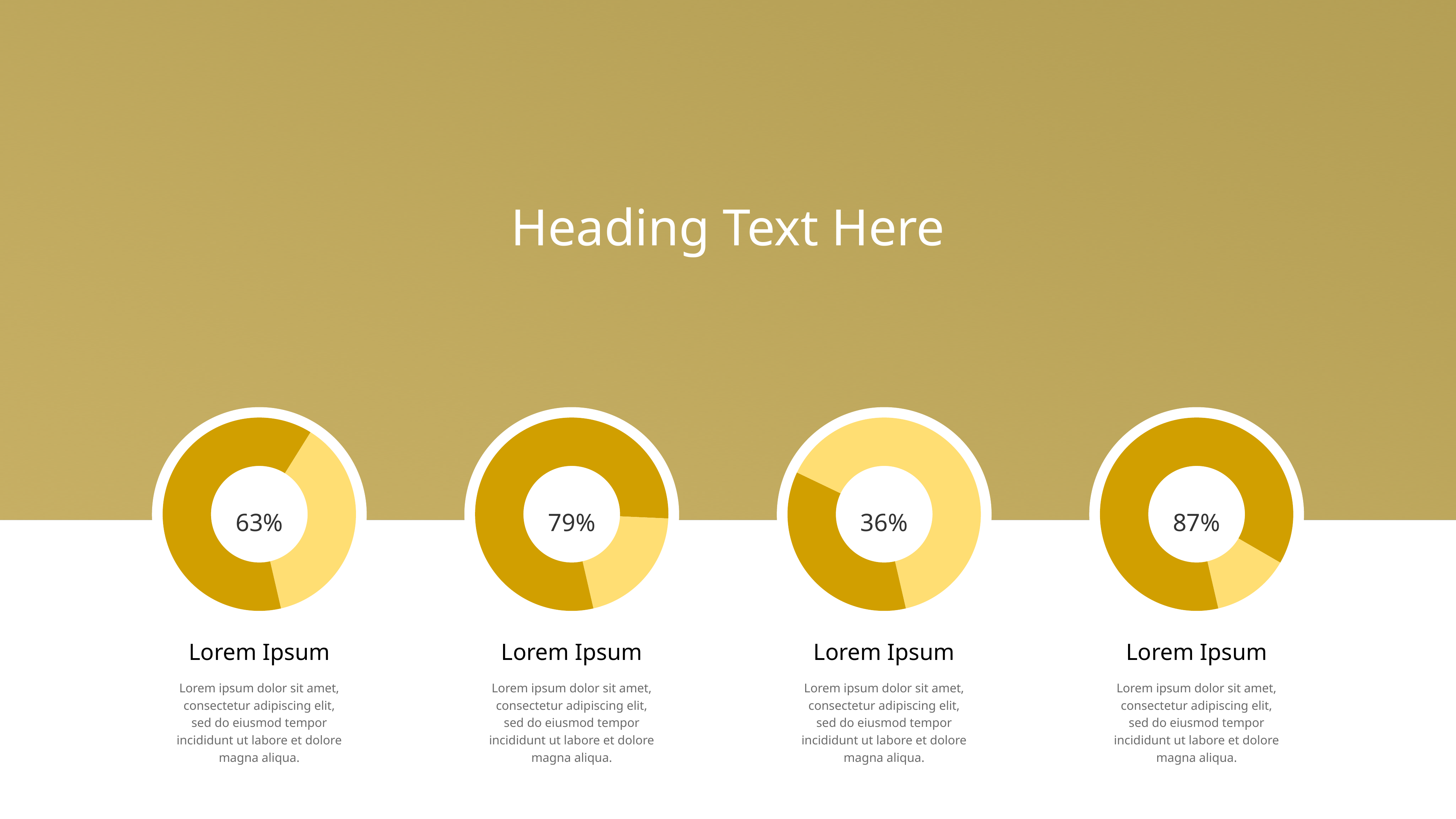
Which donut chart shows the highest percentage? The rightmost chart (87%) How many donut charts are shown on the slide? 4 Which is larger, the percentage in the leftmost donut chart or the percentage in the second donut chart from the left? The second chart (79%) What is the difference between the percentage in the second donut chart and the percentage in the third donut chart? 43% What is the difference between the percentage in the rightmost donut chart and the percentage in the leftmost donut chart? 24% What kind of chart is used to display each percentage on the slide? Donut chart Which donut chart shows the lowest percentage? The third chart from the left (36%) What percentage is shown in the centre of the third donut chart from the left? 36% What percentage is shown in the centre of the leftmost donut chart? 63% What percentage is shown in the centre of the rightmost donut chart? 87% What is the heading text at the top of the slide? Heading Text Here What percentage is shown in the centre of the second donut chart from the left? 79%